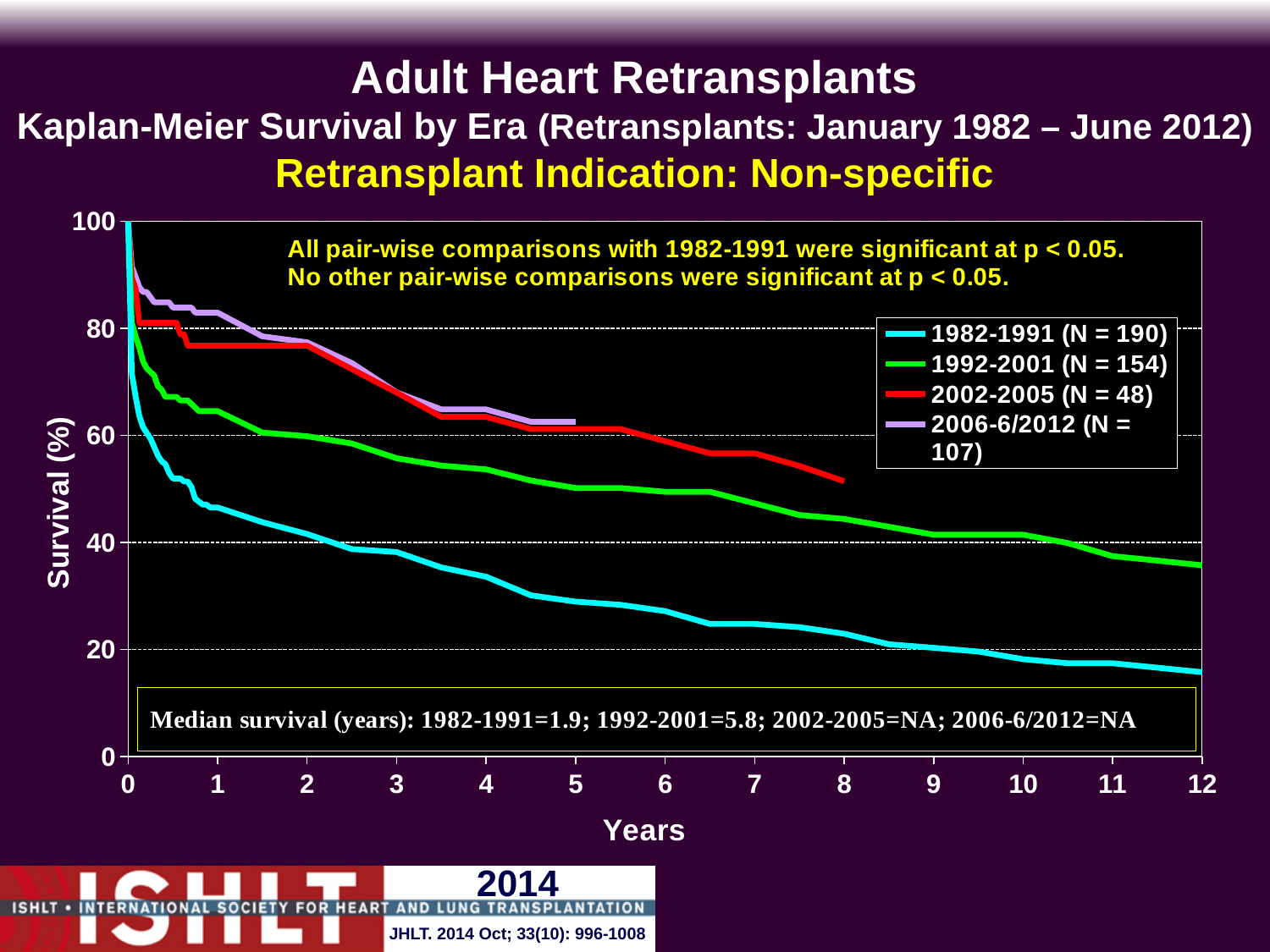
What is the N for the 2006-6/2012 era shown in the legend? 107 Is the survival for the 1982-1991 era at 12 years greater or less than 20? less What is the median survival in years for the 1982-1991 era? 1.9 How many series (eras) does the legend list? 4 What is the median survival in years for the 1992-2001 era? 5.8 Which era has the lowest survival curve across the chart? 1982-1991 What kind of chart is shown on the slide? line chart At 6 years, which era has higher survival: 1992-2001 or 1982-1991? 1992-2001 What is the N for the 1982-1991 era shown in the legend? 190 Is the survival for the 2002-2005 era at 8 years greater or less than 40? greater Is the survival for the 1992-2001 era at 12 years greater or less than 40? less What is the median survival listed for the 2002-2005 era? NA